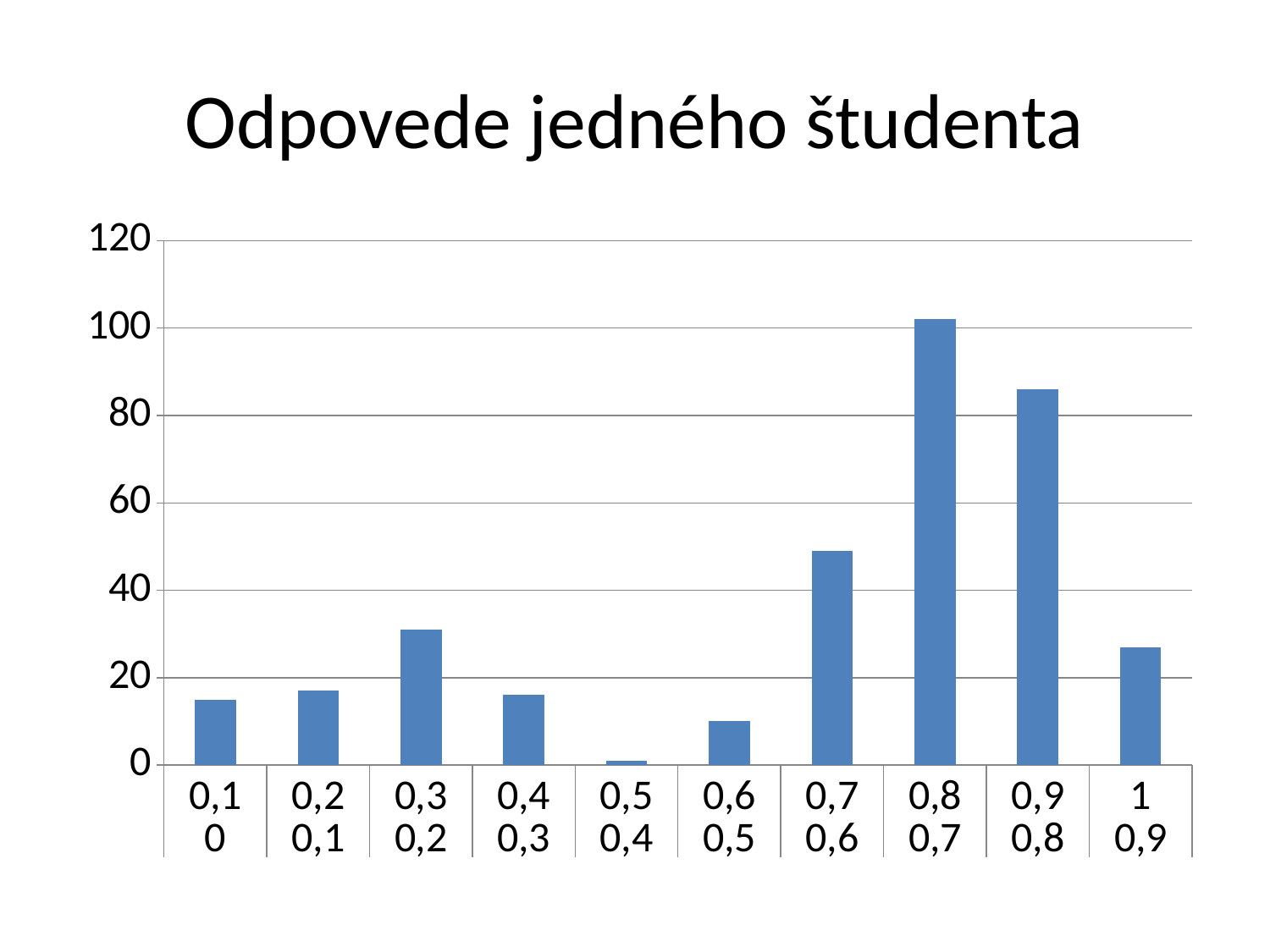
Is the value for the category 0,7 (0,6) greater or less than 60? less What kind of chart is shown on the slide? bar chart Which category has the lowest bar? 0,5 (0,4) How many bars (categories) does the chart show? 10 Which is larger, the value for 0,3 (0,2) or the value for 1 (0,9)? 0,3 (0,2) What is the title of the chart? Odpovede jedného študenta Is the value for the category 0,6 (0,5) greater or less than 20? less Is the value for the category 0,8 (0,7) greater or less than 100? greater Which is larger, the value for 0,8 (0,7) or the value for 0,9 (0,8)? 0,8 (0,7) Which category has the highest bar? 0,8 (0,7)